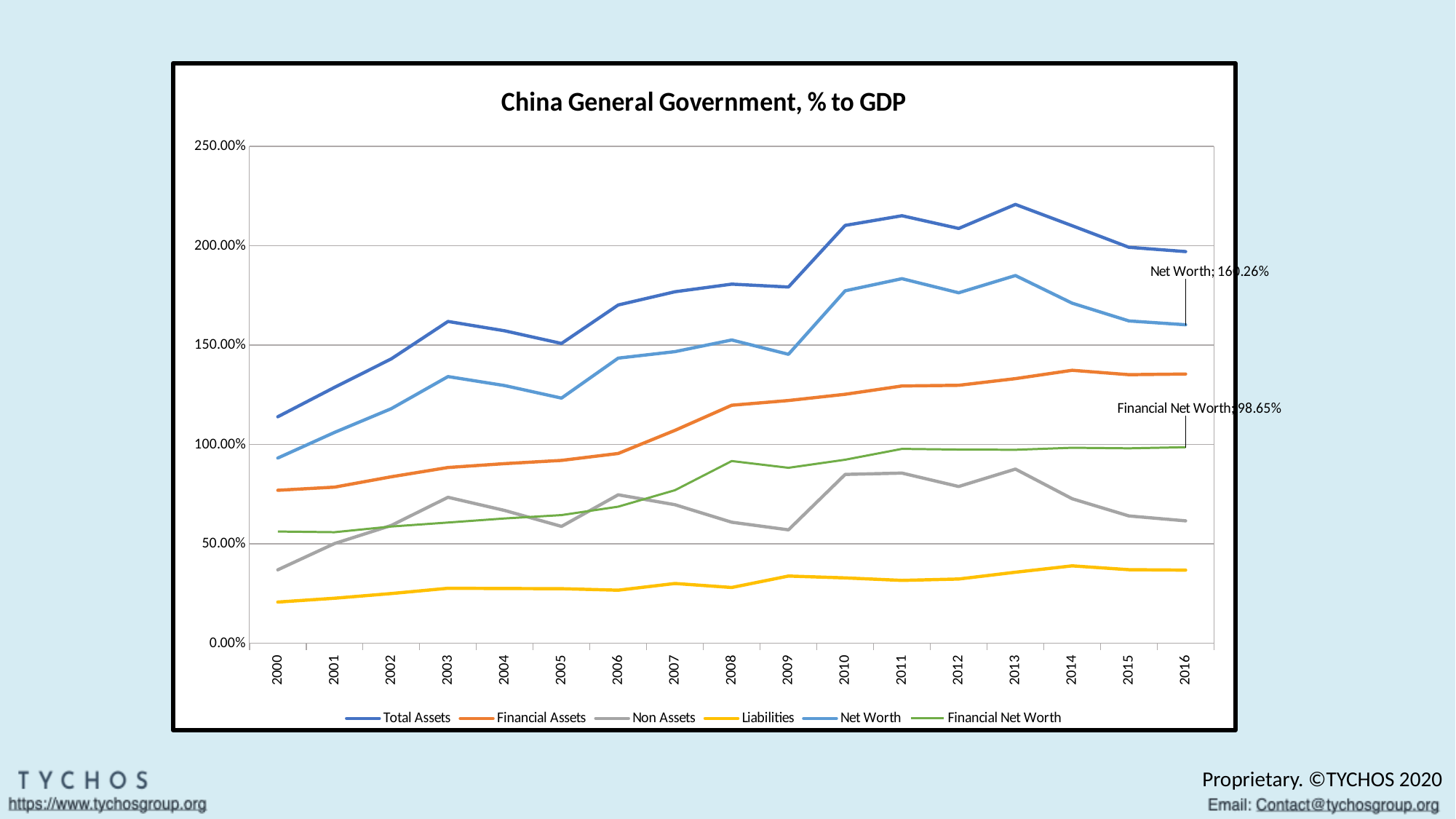
What is the data label value for Net Worth in 2016? 160.26% What is the title of the chart? China General Government, % to GDP What is the data label value for Financial Net Worth in 2016? 98.65% How many years are shown on the x axis? 17 In which year does Total Assets reach its peak? 2013 Is the value for Total Assets in 2013 greater or less than 200%? greater What kind of chart is shown on the slide? line chart In 2008, which is larger: Non Assets or Financial Net Worth? Financial Net Worth How many series does the legend list? 6 Which series has the lowest values across all years? Liabilities Which series has the highest value in 2016? Total Assets Is the value for Liabilities in 2016 greater or less than 50%? less